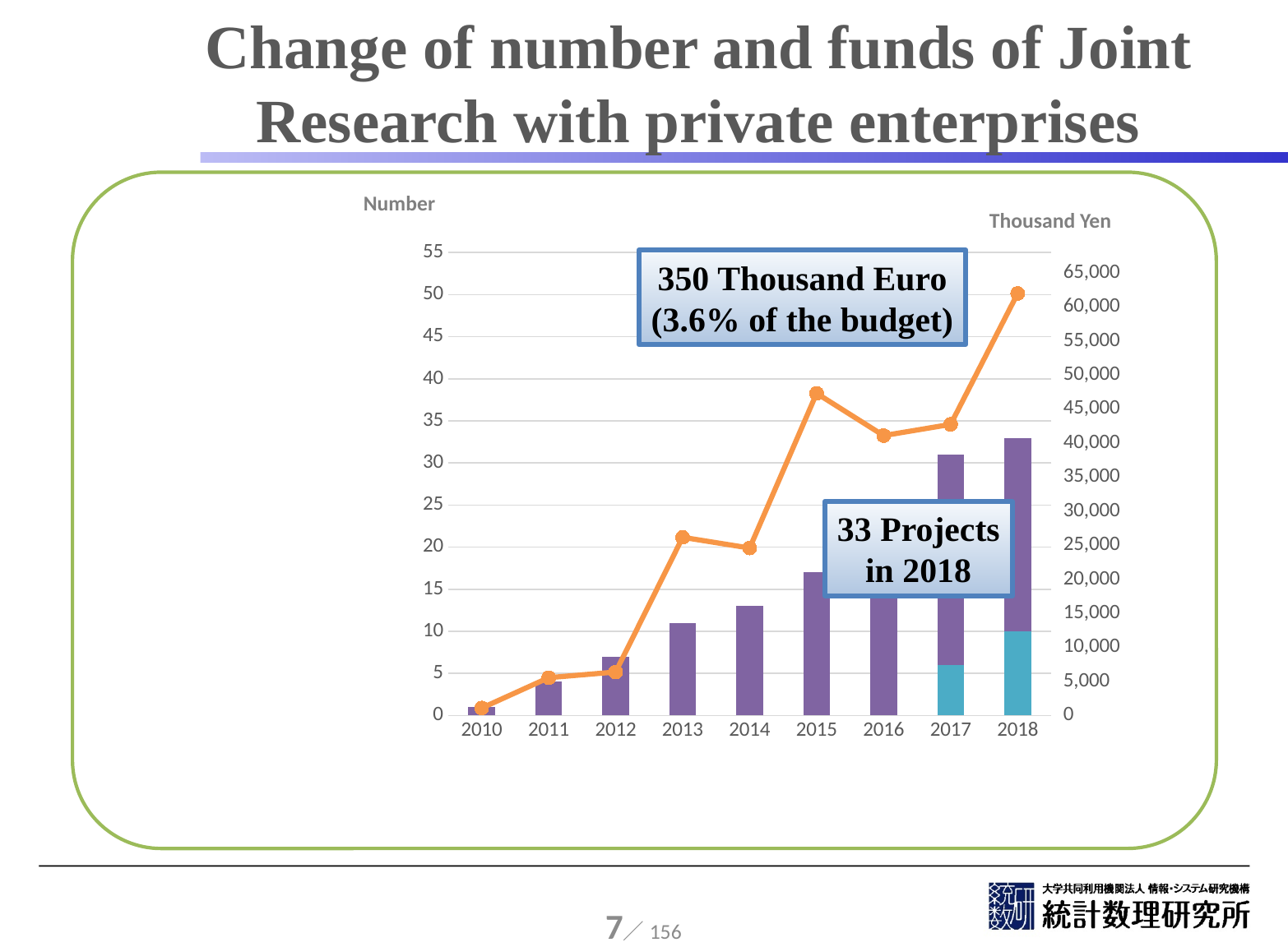
What kind of chart is shown on the slide? Combined bar and line chart How many years are shown on the x axis of the chart? 9 Is the bar value for 2017 greater or less than 30? greater Is the bar value for 2013 greater or less than 10? greater Which year has the tallest bar in the chart? 2018 According to the annotation on the chart, how many projects were there in 2018? 33 Which year has the shortest bar in the chart? 2010 Is the orange line value for 2015 greater or less than 45,000 Thousand Yen? greater In which year does the orange line (Thousand Yen) reach its highest point? 2018 What is the label of the right-hand vertical axis of the chart? Thousand Yen Which year has a higher orange line value, 2015 or 2016? 2015